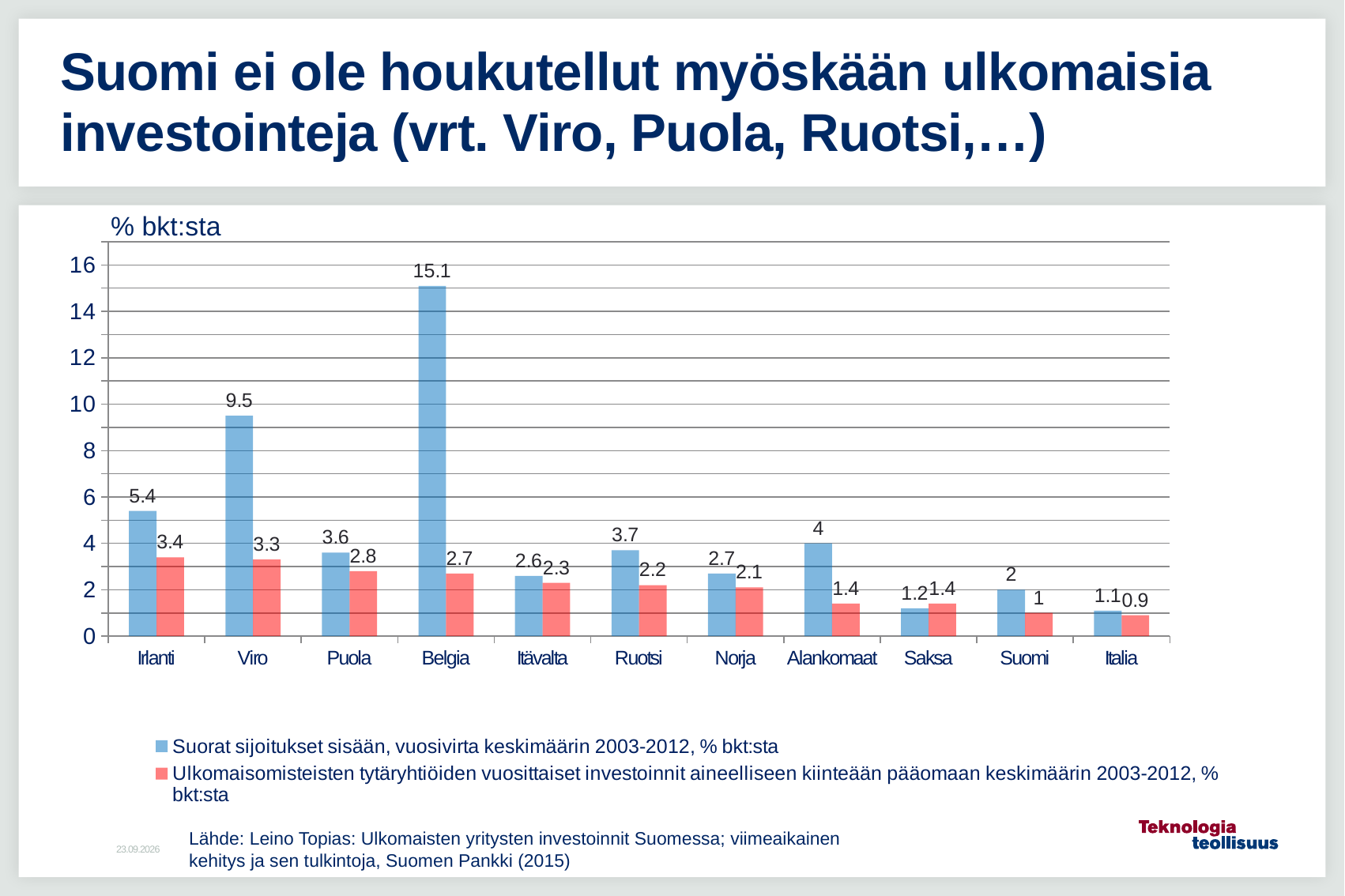
Is the 'Suorat sijoitukset sisään' value for Viro greater or less than 8? greater What is the value of 'Ulkomaisomisteisten tytäryhtiöiden vuosittaiset investoinnit aineelliseen kiinteään pääomaan keskimäärin 2003-2012, % bkt:sta' for Viro? 3.3 What unit label is shown above the y axis of the chart? % bkt:sta What is the value of 'Suorat sijoitukset sisään, vuosivirta keskimäärin 2003-2012, % bkt:sta' for Suomi? 2 Which is larger for Saksa: the 'Suorat sijoitukset sisään' value or the 'Ulkomaisomisteisten tytäryhtiöiden vuosittaiset investoinnit' value? Ulkomaisomisteisten tytäryhtiöiden vuosittaiset investoinnit Which country has the lowest value for 'Ulkomaisomisteisten tytäryhtiöiden vuosittaiset investoinnit aineelliseen kiinteään pääomaan keskimäärin 2003-2012, % bkt:sta'? Italia What kind of chart is shown on the slide? Bar chart Which country has the highest value for 'Suorat sijoitukset sisään, vuosivirta keskimäärin 2003-2012, % bkt:sta'? Belgia What is the difference between the 'Suorat sijoitukset sisään' values for Viro and Suomi? 7.5 How many countries are shown on the x axis of the chart? 11 How many series does the chart's legend list? 2 What is the value of 'Suorat sijoitukset sisään, vuosivirta keskimäärin 2003-2012, % bkt:sta' for Belgia? 15.1